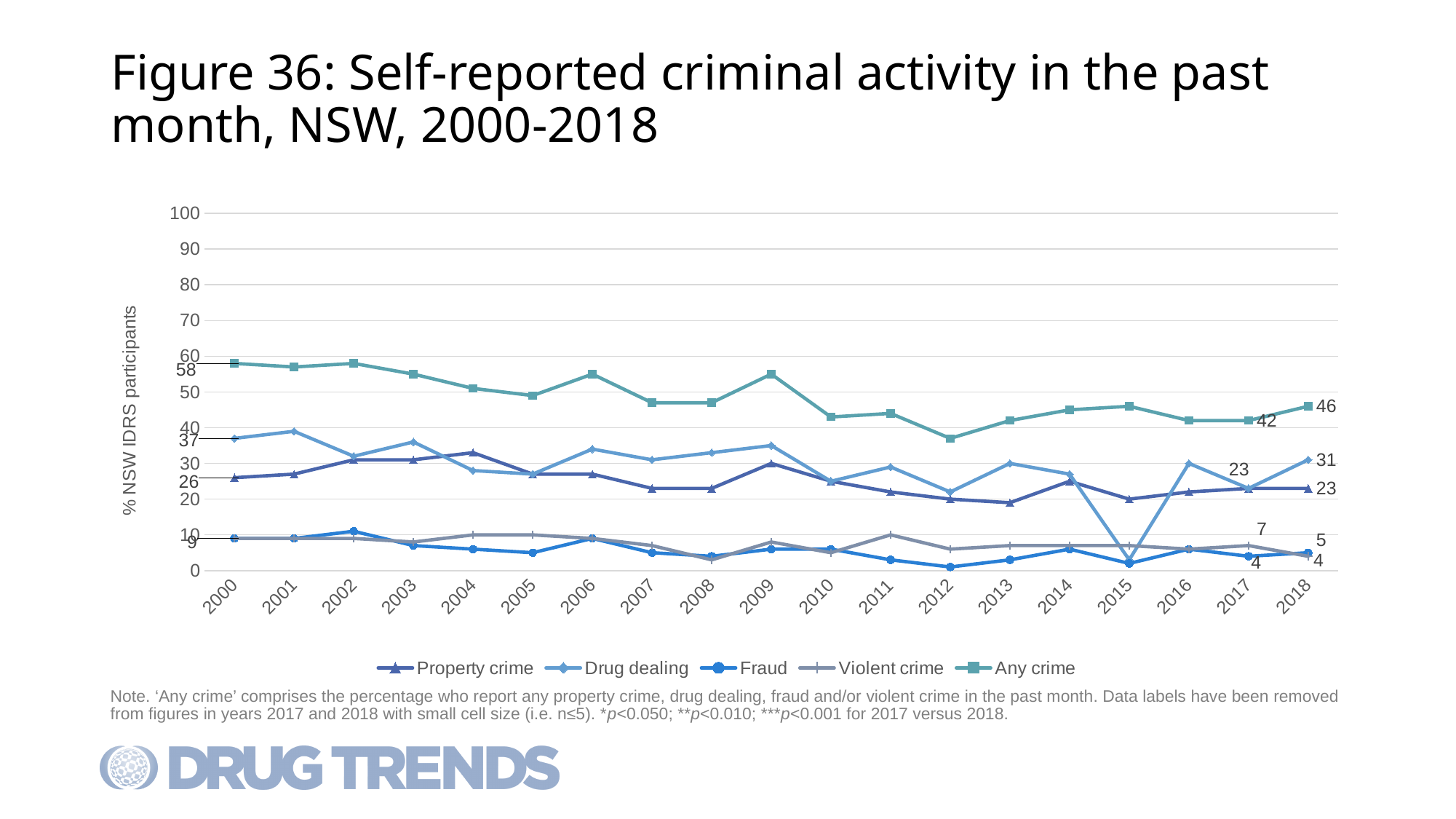
In which year is the Any crime value lowest? 2012 What is the value for Any crime in 2018? 46 What is the value for Property crime in 2018? 23 Is the value for Any crime in 2012 greater or less than 40? less What is the value for Drug dealing in 2018? 31 What type of chart is shown on the slide? Line chart By how much did the Any crime value fall between 2000 and 2018? 12 Which is larger, the Any crime value in 2017 or in 2018? 2018 What is the value for Drug dealing in 2000? 37 How many series does the legend list? 5 What is the value for Any crime in 2017? 42 What is the value for Any crime in 2000? 58